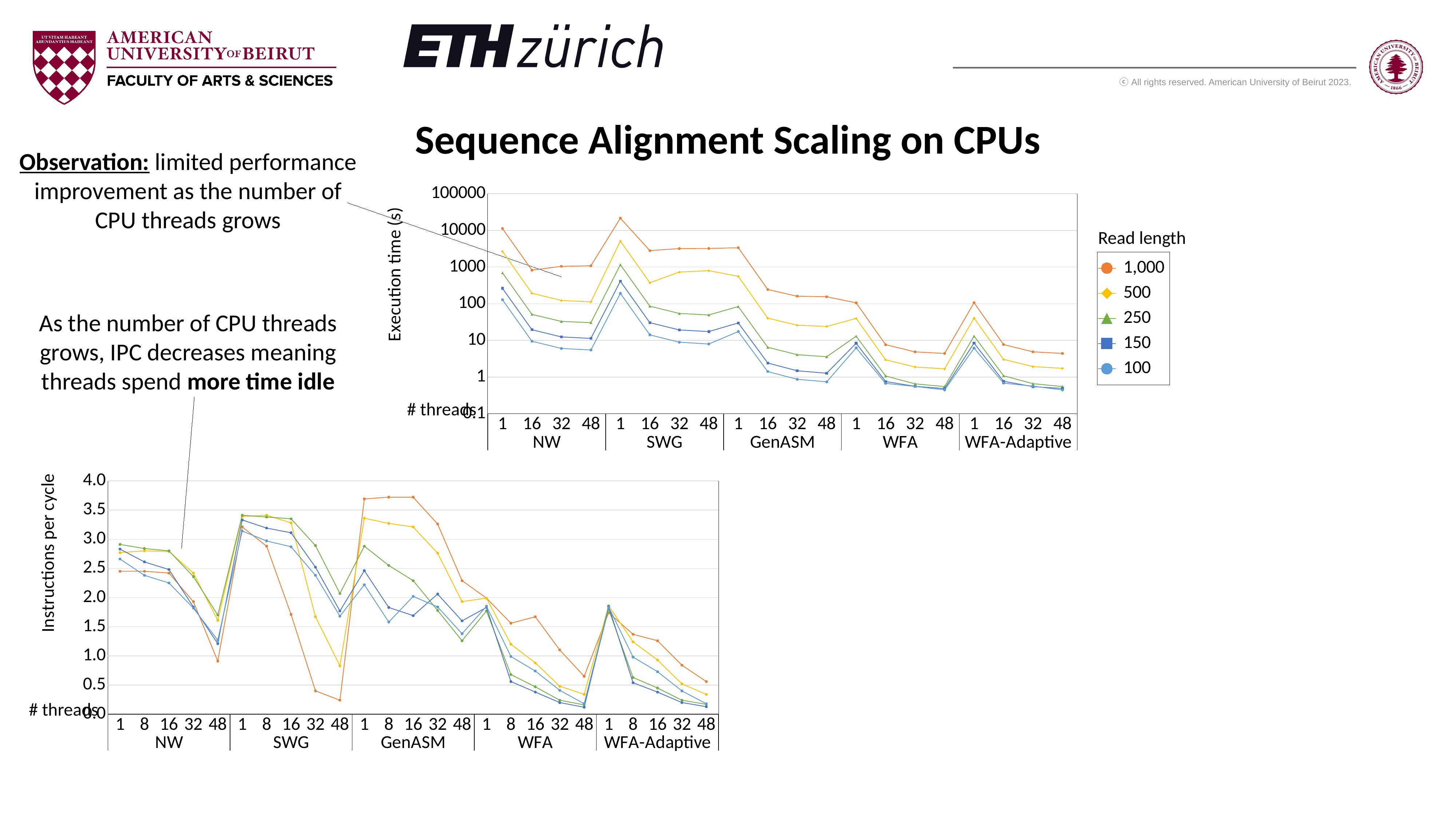
In the top chart (Execution time), how many algorithms are shown along the x axis? 5 In the top chart (Execution time), which read length has the lowest execution time across the algorithms? 100 In the top chart (Execution time), which algorithm has the highest execution time at 1 thread for read length 1,000? SWG In the top chart (Execution time), is the value for SWG at 1 thread with read length 1,000 greater or less than 10000? greater What kind of chart is the top chart (Execution time)? line chart In the top chart (Execution time), for NW with read length 1,000, does execution time rise or fall from 1 to 16 threads? fall In the top chart (Execution time), how many read lengths does the legend list? 5 In the bottom chart (Instructions per cycle), is the value of the orange line for SWG at 48 threads greater or less than 0.5? less In the top chart (Execution time), is the value for WFA at 48 threads with read length 100 greater or less than 1? less In the bottom chart (Instructions per cycle), for WFA, does the orange line rise or fall from 1 to 48 threads? fall In the bottom chart (Instructions per cycle), how many thread counts are shown for each algorithm? 5 In the top chart (Execution time), what is the title of the legend? Read length